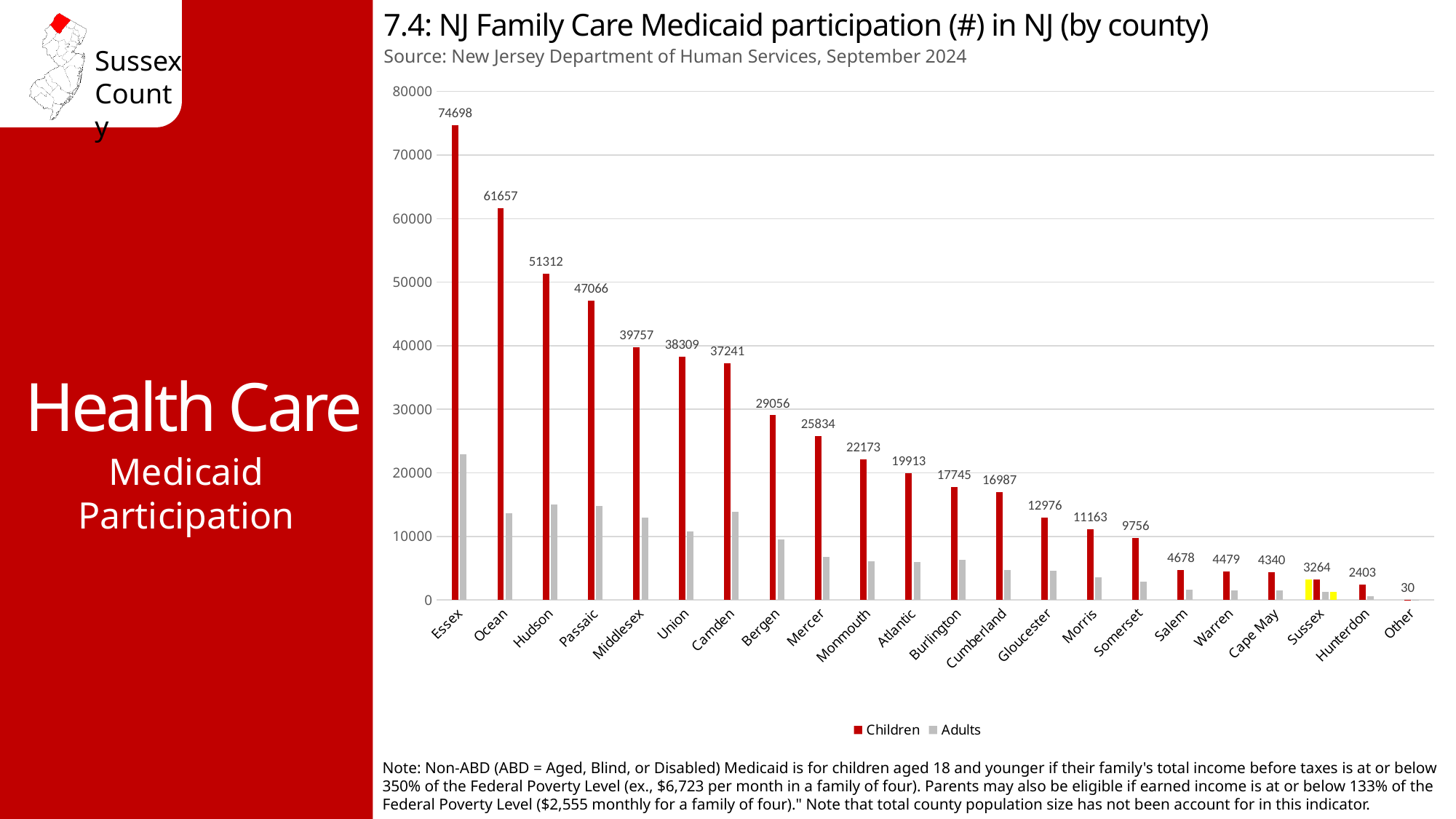
Which has a larger Children value, Bergen or Mercer? Bergen Which category has the lowest Children value? Other Is the Adults value for Essex greater or less than 20000? greater What is the Children value for Monmouth? 22173 What is the difference between the Children values for Essex and Ocean? 13041 What is the Children value for Essex? 74698 Which county has the highest Children value? Essex Is the Adults value for Hudson greater or less than 20000? less How many categories are shown on the x axis? 22 How many series does the legend list? 2 What kind of chart is shown on the slide? Bar chart What is the Children value for Sussex? 3264